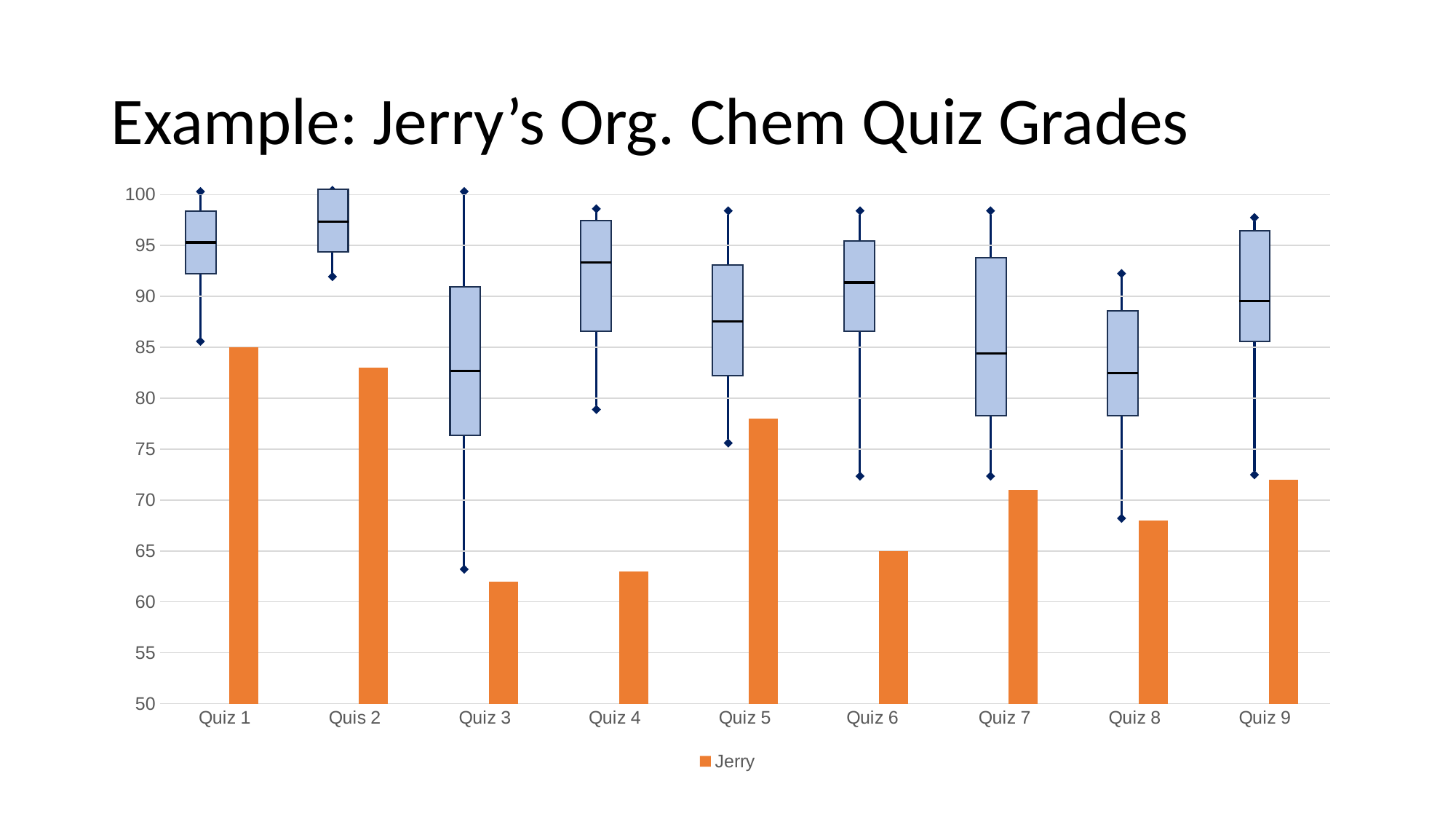
Is Jerry's value for Quiz 8 greater or less than 70? less Is Jerry's bar for Quiz 1 or Quiz 3 higher? Quiz 1 How many series does the legend list? 1 Is Jerry's value for Quis 2 greater or less than 80? greater Do Jerry's bars rise or fall from Quiz 1 to Quiz 3? fall Is Jerry's bar for Quiz 5 or Quiz 6 higher? Quiz 5 What is Jerry's grade on Quiz 1? 85 What is the name of the series shown in the legend? Jerry What kind of chart is used to show Jerry's quiz grades on this slide? bar chart How many quizzes are shown along the x axis? 9 What is Jerry's grade on Quiz 6? 65 On which quiz is Jerry's bar the highest? Quiz 1